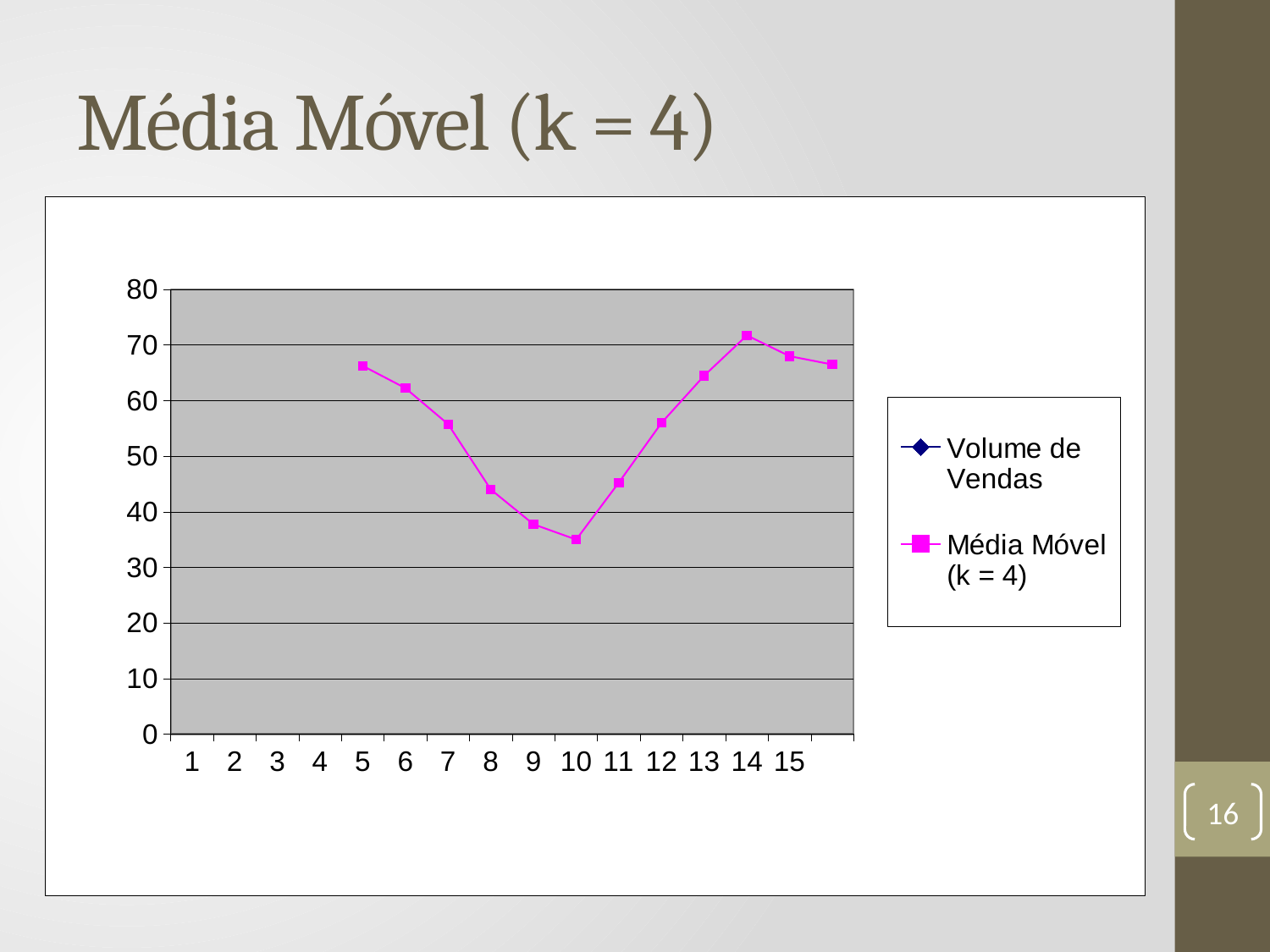
Is the Média Móvel (k = 4) value at x = 14 greater or less than 70? greater How many series does the legend list? 2 At which x-axis label does the Média Móvel (k = 4) line reach its lowest value? 10 Is the Média Móvel (k = 4) value at x = 5 greater or less than 60? greater How many numbered labels are shown on the x axis? 15 At which x-axis label does the Média Móvel (k = 4) line reach its highest value? 14 Does the Média Móvel (k = 4) line rise or fall between x = 5 and x = 10? fall Which has the larger Média Móvel (k = 4) value, x = 7 or x = 9? 7 What kind of chart is shown on the slide? line chart What is the title of the slide containing the chart? Média Móvel (k = 4) Is the Média Móvel (k = 4) value at x = 10 greater or less than 40? less What are the two series names listed in the legend? Volume de Vendas; Média Móvel (k = 4)